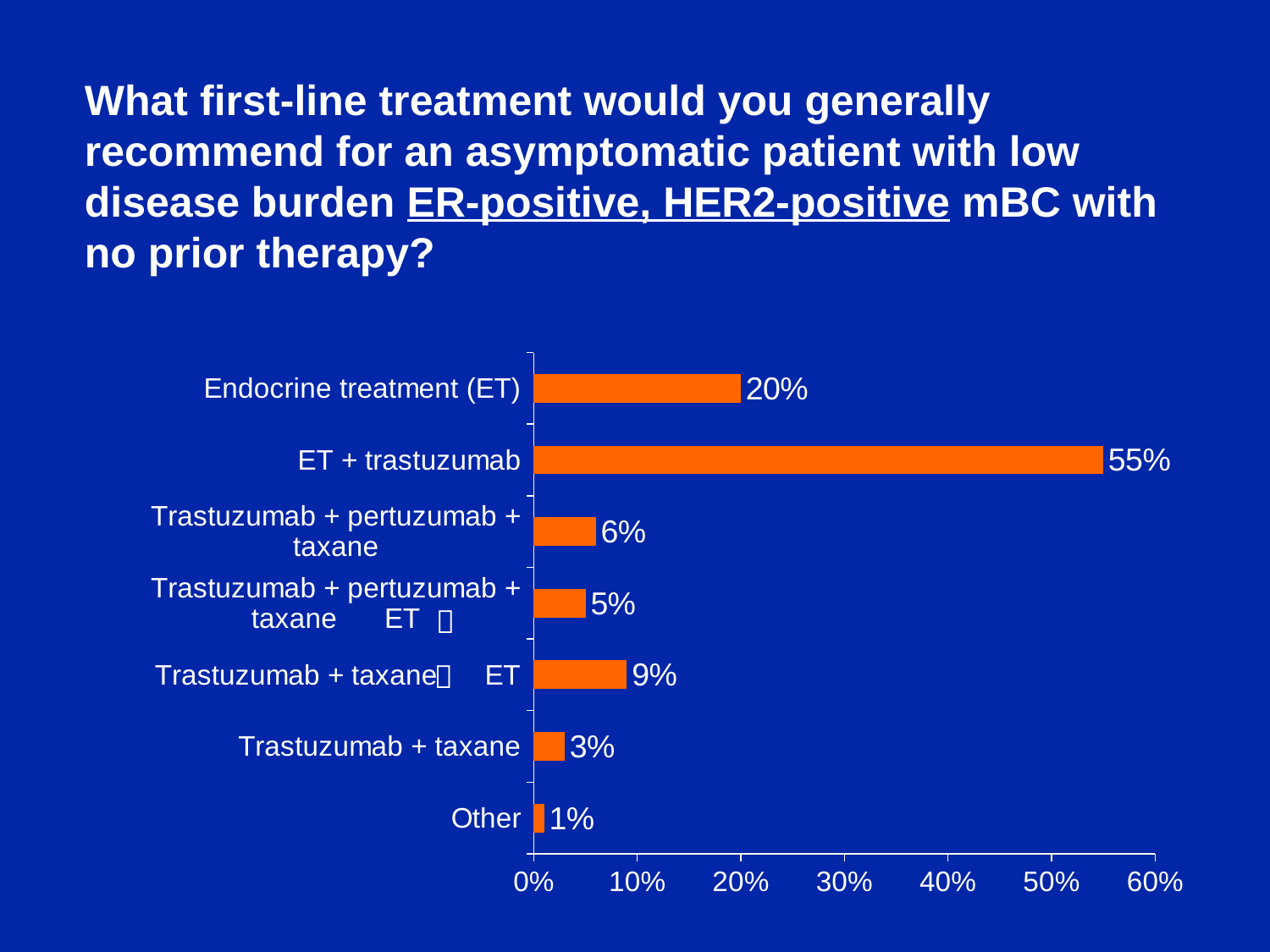
Which treatment option has the highest percentage? ET + trastuzumab What is the difference in percentage points between ET + trastuzumab and Endocrine treatment (ET)? 35 Which has a larger value: Endocrine treatment (ET) or Trastuzumab + pertuzumab + taxane? Endocrine treatment (ET) What is the maximum value shown on the horizontal axis? 60% What kind of chart is shown on the slide? Bar chart What is the value shown for Trastuzumab + pertuzumab + taxane (without ET)? 6% Is the value for ET + trastuzumab greater or less than 50%? greater What percentage of respondents chose ET + trastuzumab? 55% Which option has the lowest percentage? Other How many treatment options (bars) are shown in the chart? 7 What percentage of respondents chose Endocrine treatment (ET)? 20% What percentage of respondents chose Other? 1%